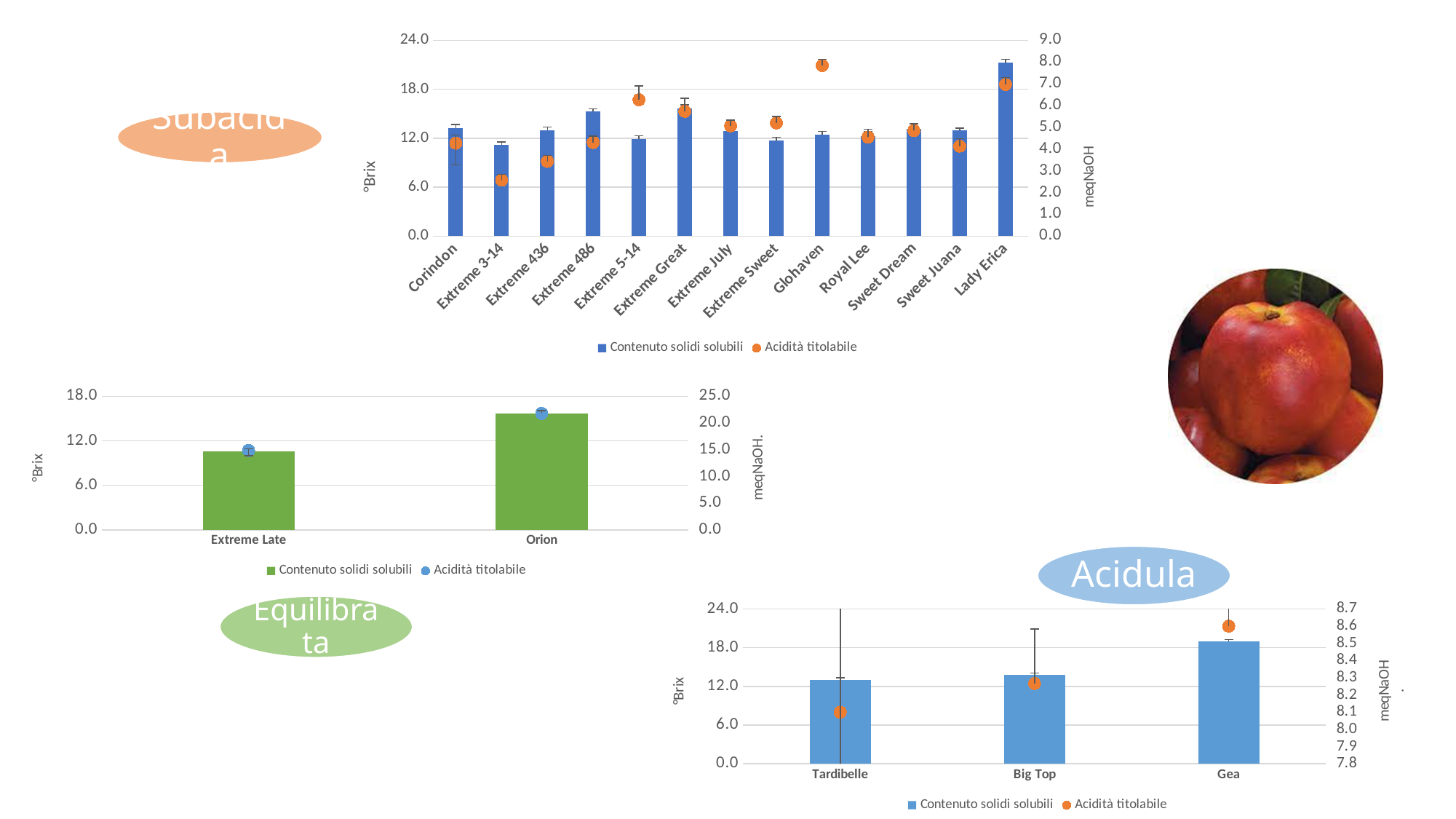
In the bottom-right chart (Acidula), is the Contenuto solidi solubili value for Gea greater or less than 18.0 °Brix? greater In the top chart (Subacida), how many categories are shown on the x axis? 13 In the bottom-left chart (Equilibrata), which category has the larger Contenuto solidi solubili bar, Extreme Late or Orion? Orion In the top chart (Subacida), how many series does the legend list? 2 What kind of chart is the bottom-right chart (Acidula)? Combination chart (bars with point markers on a secondary axis) In the top chart (Subacida), is the Contenuto solidi solubili value for Lady Erica greater or less than 18.0 °Brix? greater In the bottom-right chart (Acidula), how many categories are shown on the x axis? 3 In the top chart (Subacida), is the Contenuto solidi solubili value for Extreme 3-14 greater or less than 12.0 °Brix? less In the bottom-right chart (Acidula), which category has the highest Contenuto solidi solubili bar? Gea In the top chart (Subacida), which category has the highest Contenuto solidi solubili bar? Lady Erica In the top chart (Subacida), which category has the highest Acidità titolabile marker? Glohaven